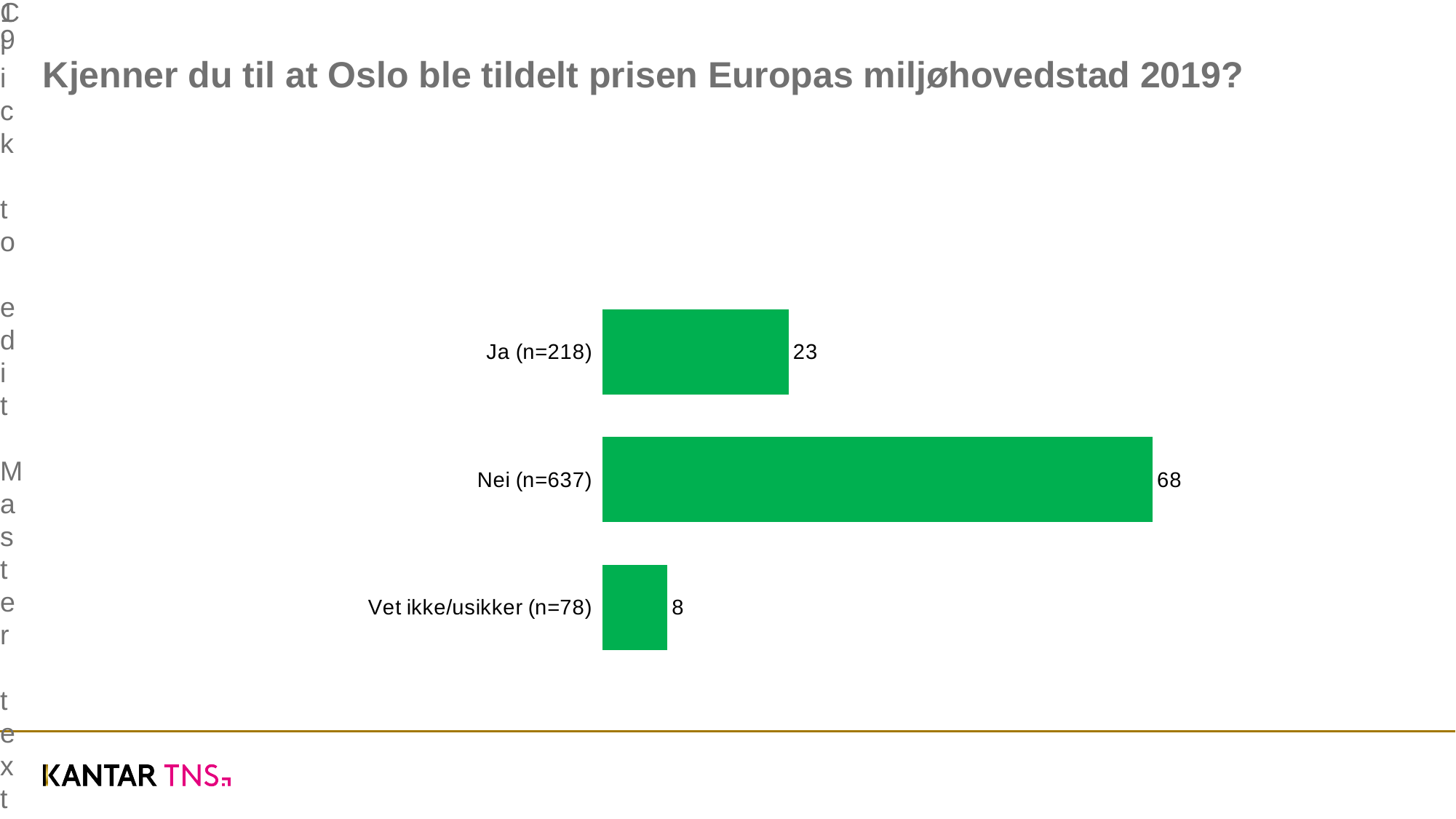
Which is larger, the value for Ja (n=218) or the value for Vet ikke/usikker (n=78)? Ja (n=218) What is the value for Nei (n=637)? 68 What is the difference between the values for Ja (n=218) and Vet ikke/usikker (n=78)? 15 What colour are the bars in the chart? Green What is the value for Vet ikke/usikker (n=78)? 8 What kind of chart is shown on the slide? Bar chart What is the difference between the values for Nei (n=637) and Ja (n=218)? 45 How many categories are shown in the chart? 3 Which category has the lowest value? Vet ikke/usikker (n=78) Which category has the highest value? Nei (n=637) What is the value for Ja (n=218)? 23 What is the title of the slide? Kjenner du til at Oslo ble tildelt prisen Europas miljøhovedstad 2019?